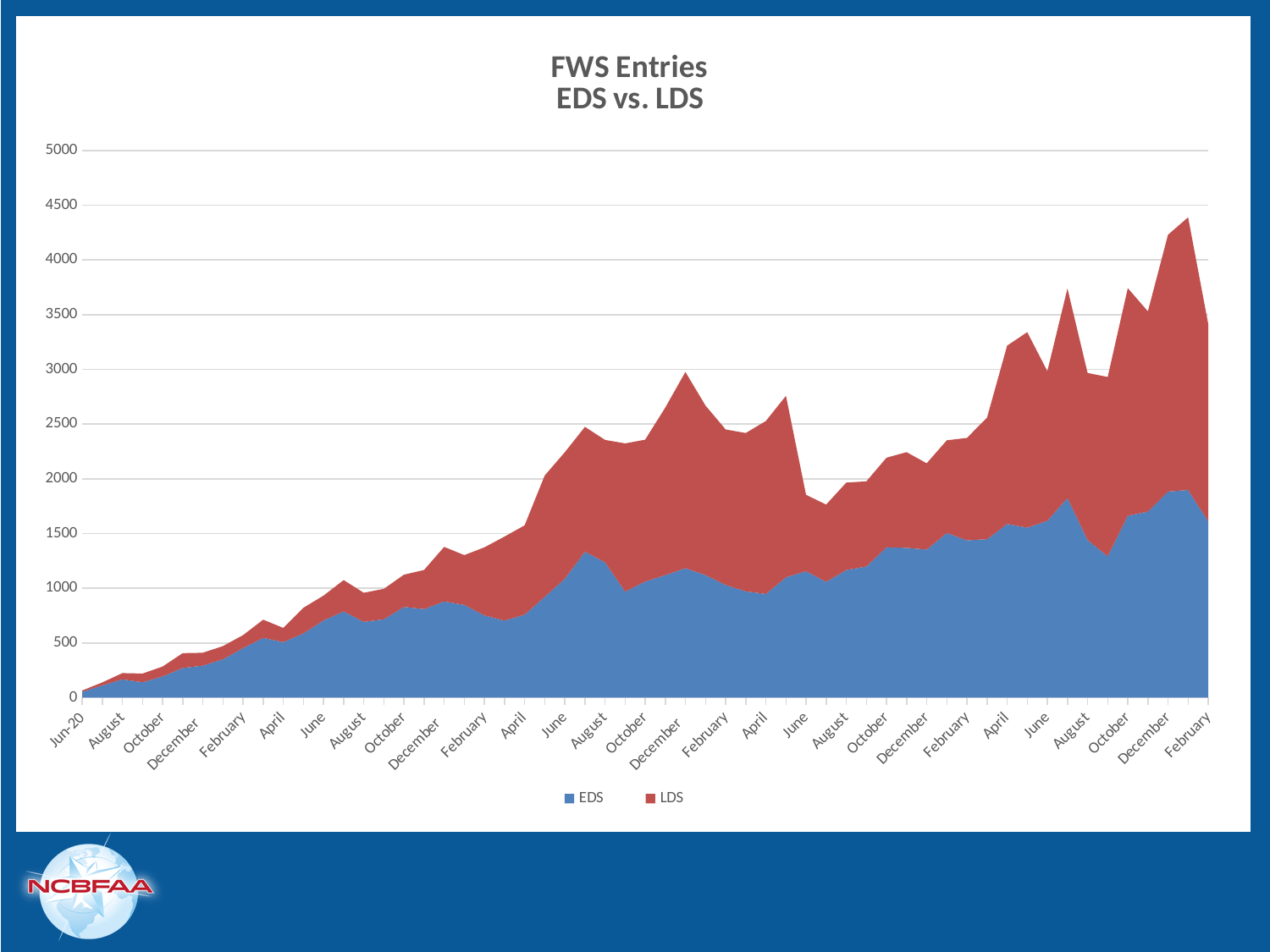
Is the stacked total of EDS and LDS at Jun-20 greater or less than 500? less Is the EDS value at the final February point greater or less than 1000? greater Which series is shown in blue? EDS Is the stacked total of EDS and LDS at the first December label greater or less than 1000? less Overall, do the stacked FWS entries rise or fall from Jun-20 to the end of the chart? rise What is the highest value shown on the vertical axis? 5000 How many series does the legend list? 2 What is the title of the chart? FWS Entries EDS vs. LDS What kind of chart is shown on the slide? Area chart